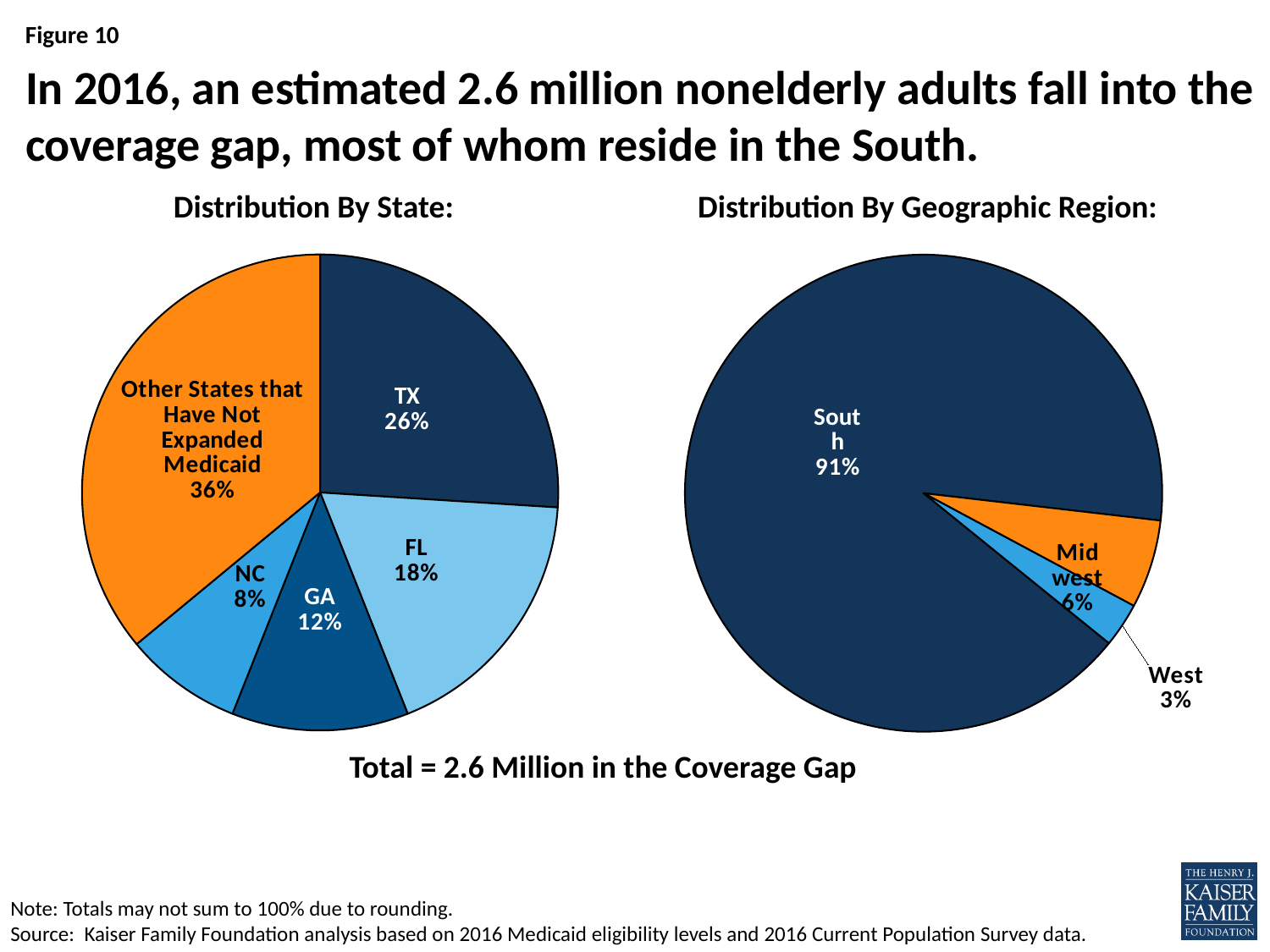
In the 'Distribution By State' pie chart, how many percentage points larger is TX than FL? 8 In the 'Distribution By State' pie chart, what share is labeled for FL? 18% In the 'Distribution By Geographic Region' pie chart, what share is in the South? 91% In the 'Distribution By State' pie chart, what share of the coverage gap is in TX? 26% In the 'Distribution By Geographic Region' pie chart, what is the value for the West? 3% In the 'Distribution By State' pie chart, how many slices are there? 5 In the 'Distribution By State' pie chart, which slice is the smallest? NC In the 'Distribution By Geographic Region' pie chart, how many percentage points larger is the Midwest than the West? 3 In the 'Distribution By State' pie chart, what is the value for GA? 12% In the 'Distribution By State' pie chart, which is larger, GA or NC? GA In the 'Distribution By State' pie chart, which slice is the largest? Other States that Have Not Expanded Medicaid What type of chart is used for the 'Distribution By Geographic Region'? Pie chart